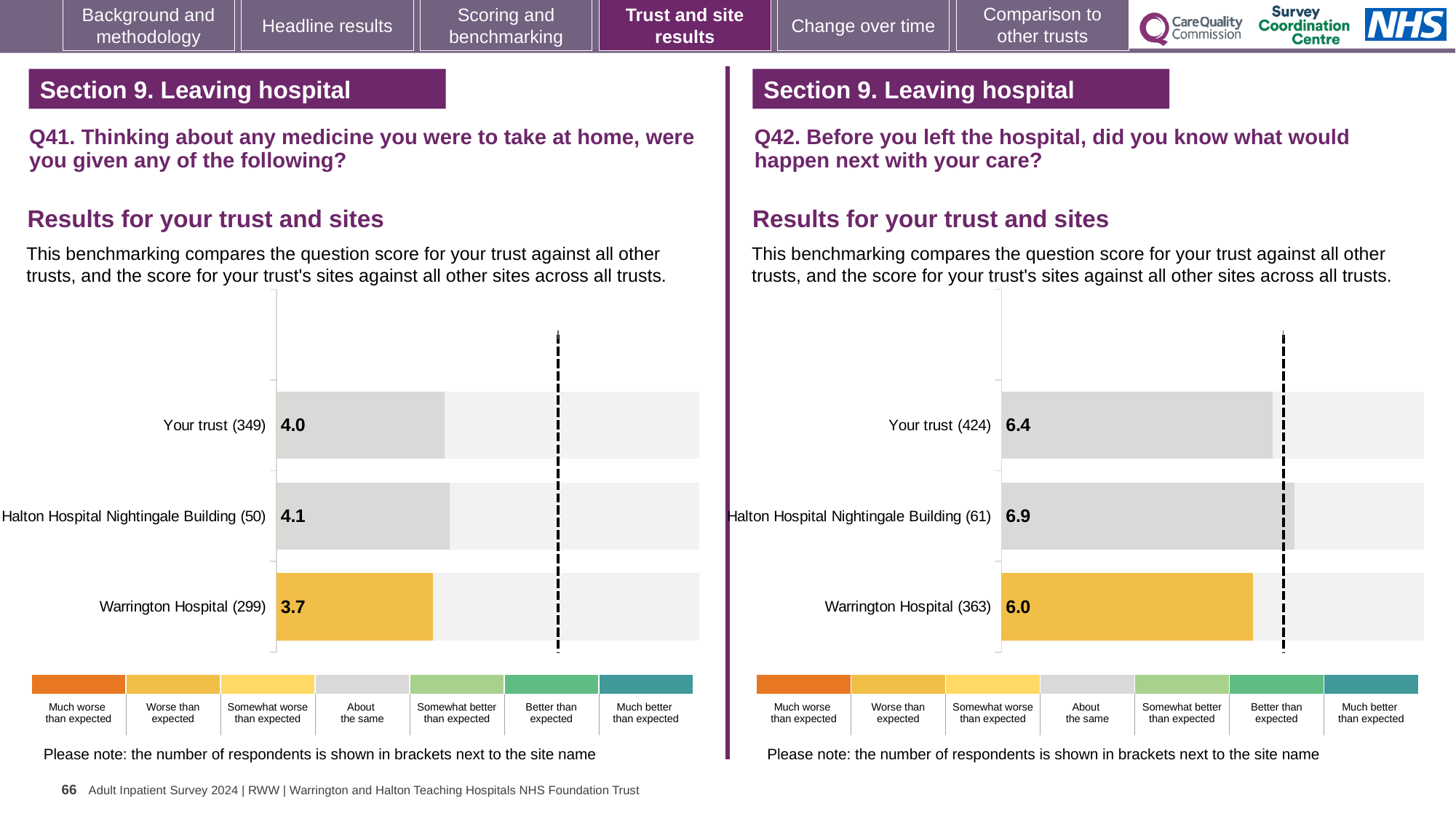
In the Q41 chart on the left, what is the score for Your trust? 4.0 In the Q42 chart on the right, what is the difference between the scores for Your trust and Warrington Hospital? 0.4 In the Q41 chart on the left, which site or trust has the highest score? Halton Hospital Nightingale Building In the Q41 chart on the left, how many respondents are shown in brackets for Warrington Hospital? 299 In the Q41 chart on the left, what is the difference between the scores for Halton Hospital Nightingale Building and Warrington Hospital? 0.4 In the Q41 chart on the left, what is the score for Warrington Hospital? 3.7 How many bars are plotted in the Q41 chart on the left? 3 In the Q42 chart on the right, which site or trust has the lowest score? Warrington Hospital What kind of chart is used for the Q42 results on the right? Bar chart In the Q42 chart on the right, what is the score for Halton Hospital Nightingale Building? 6.9 In the Q42 chart on the right, how many respondents are shown in brackets for Your trust? 424 In the Q42 chart on the right, which has the larger score, Your trust or Warrington Hospital? Your trust